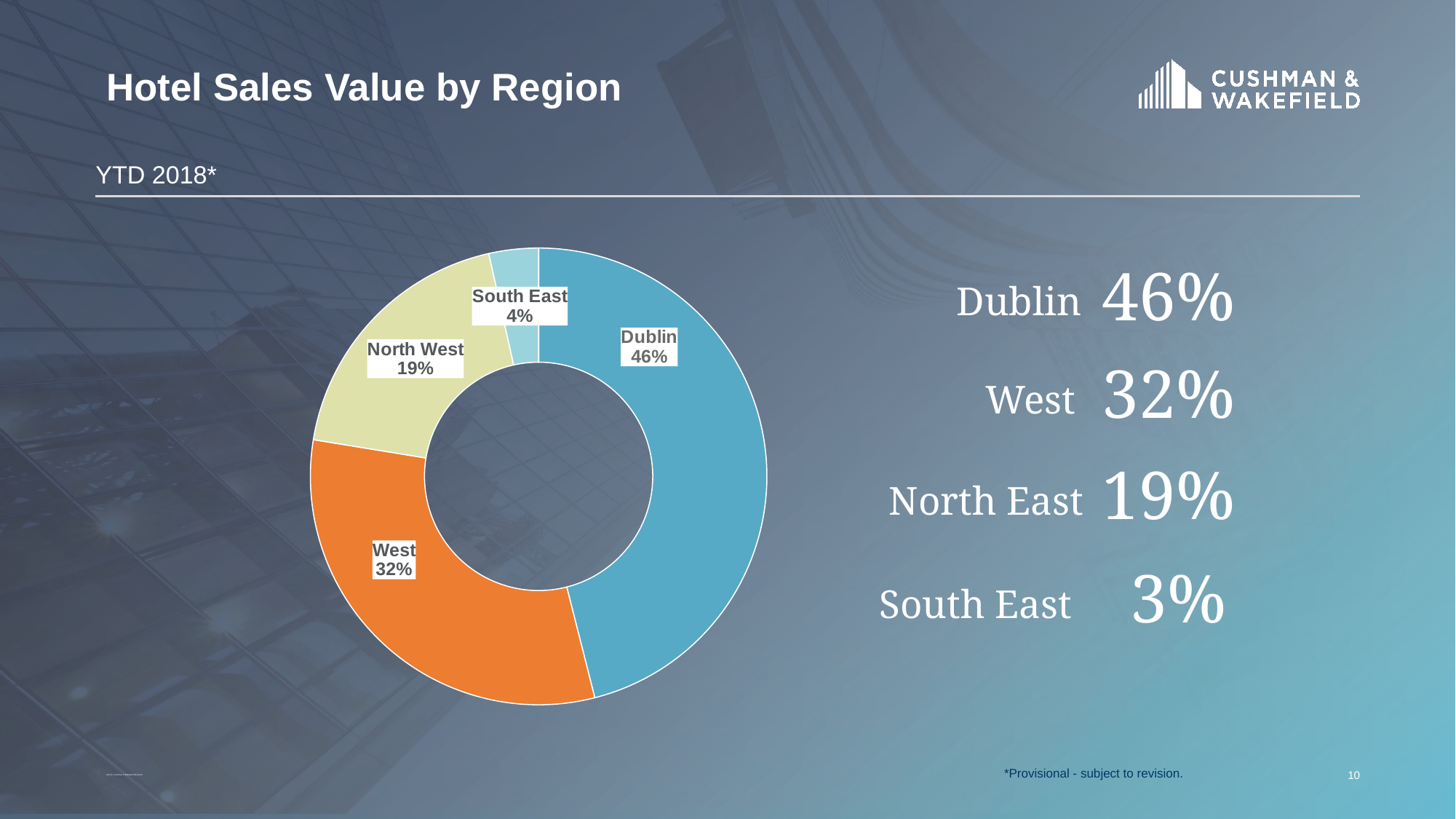
Which region has the smallest slice in the chart? South East According to the chart's data labels, what share of hotel sales value does West account for? 32% According to the chart's data labels, what share of hotel sales value does Dublin account for? 46% Which slice is larger in the chart, West or North West? West What is the title of the chart on the slide? Hotel Sales Value by Region Which region has the largest slice in the chart? Dublin What kind of chart is shown on the slide? Pie chart (donut) How many regions (slices) are shown in the chart? 4 According to the chart's data labels, what share of hotel sales value does South East account for? 4% Based on the chart's data labels, what is the difference in percentage points between Dublin and West? 14 percentage points According to the chart's data labels, what share of hotel sales value does North West account for? 19% What colour is the West slice in the chart? Orange